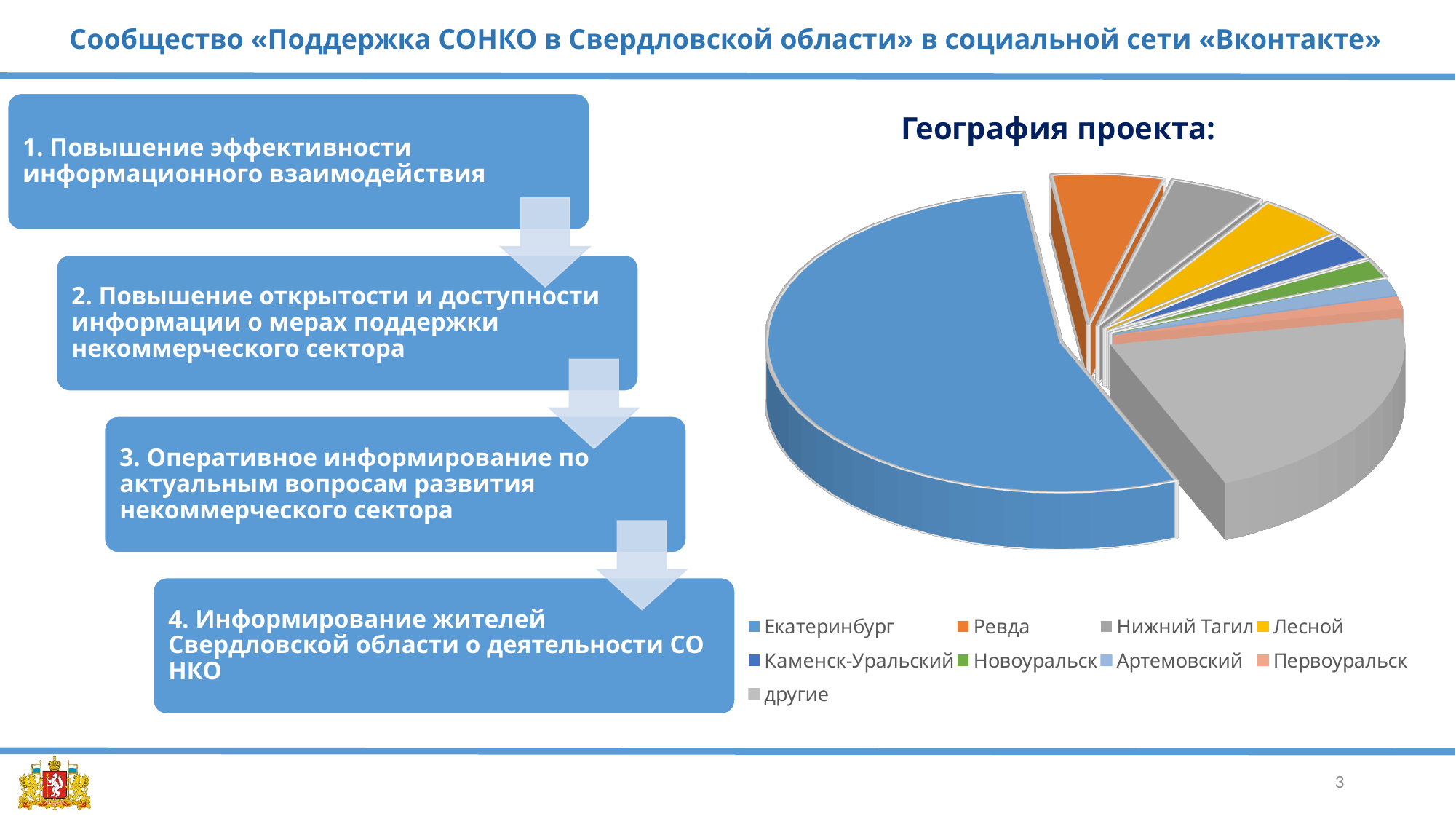
Which category has the largest slice in the «География проекта:» pie chart? Екатеринбург How many categories does the legend of the «География проекта:» pie chart list? 9 What is the title of the pie chart on the slide? География проекта: Which category is shown in orange in the «География проекта:» pie chart? Ревда What kind of chart is shown under the title «География проекта:»? pie chart In the «География проекта:» pie chart, which slice is larger: Екатеринбург or другие? Екатеринбург In the «География проекта:» pie chart, which slice is larger: другие or Лесной? другие In the «География проекта:» pie chart, which slice is larger: Нижний Тагил or Каменск-Уральский? Нижний Тагил